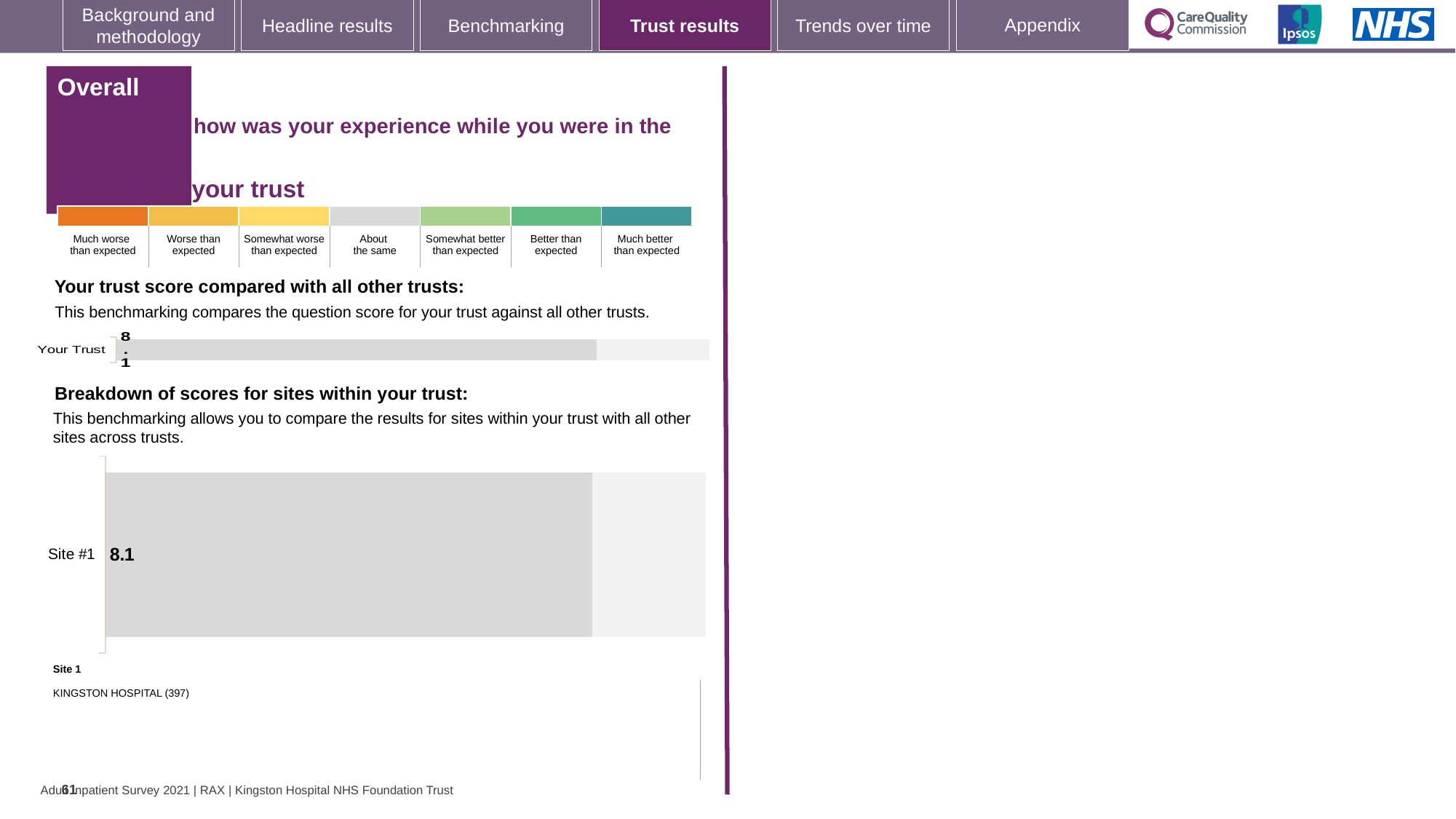
What kind of chart is used in the 'Your trust score compared with all other trusts' section? Bar chart What kind of chart is used in the 'Breakdown of scores for sites within your trust' section? Bar chart What is the category label of the single bar in the 'Your trust score compared with all other trusts' chart? Your Trust In the chart 'Your trust score compared with all other trusts', what is the score shown for Your Trust? 8.1 What is the category label of the single bar in the 'Breakdown of scores for sites within your trust' chart? Site #1 In the chart 'Breakdown of scores for sites within your trust', what is the score shown for Site #1? 8.1 How many sites are plotted in the 'Breakdown of scores for sites within your trust' chart? 1 What is the difference between the Your Trust score in the top chart and the Site #1 score in the bottom chart? 0 How many bars are plotted in the 'Your trust score compared with all other trusts' chart? 1